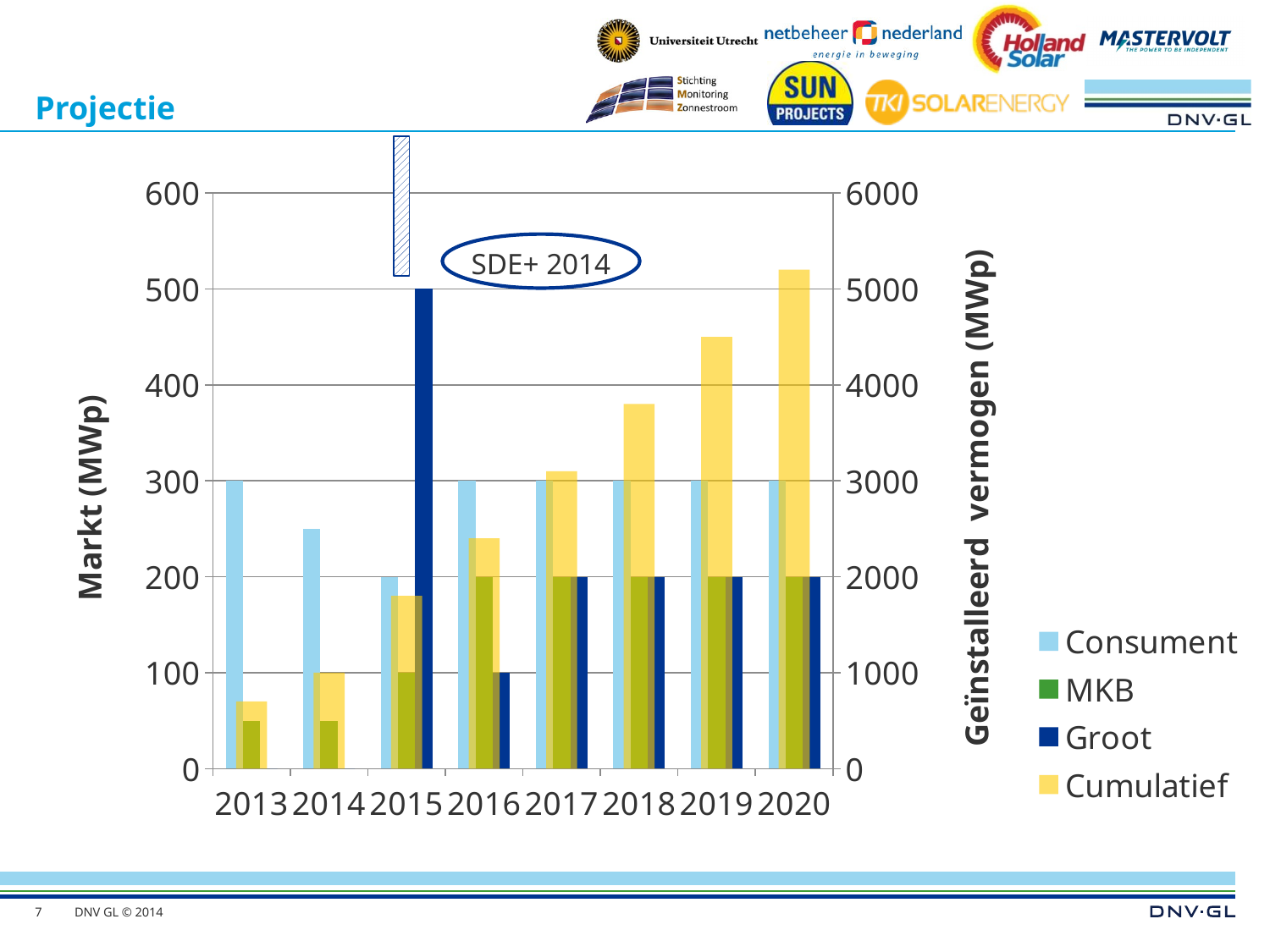
What is the Consument value for 2015 on the left axis (Markt, MWp)? 200 How many years are shown on the x axis? 8 Is the Cumulatief value for 2020 greater or less than 5000? greater In which year is the Cumulatief series highest? 2020 How many series does the legend list? 4 What is the Consument value for 2013 on the left axis (Markt, MWp)? 300 What is the MKB value for 2017 on the left axis (Markt, MWp)? 200 What is the Cumulatief value for 2014 on the right axis (Geïnstalleerd vermogen, MWp)? 1000 What is the title of the left vertical axis? Markt (MWp) What is the Groot value for 2016 on the left axis (Markt, MWp)? 100 What kind of chart is shown on the slide? bar chart Does the Cumulatief series rise or fall from 2013 to 2020? rise